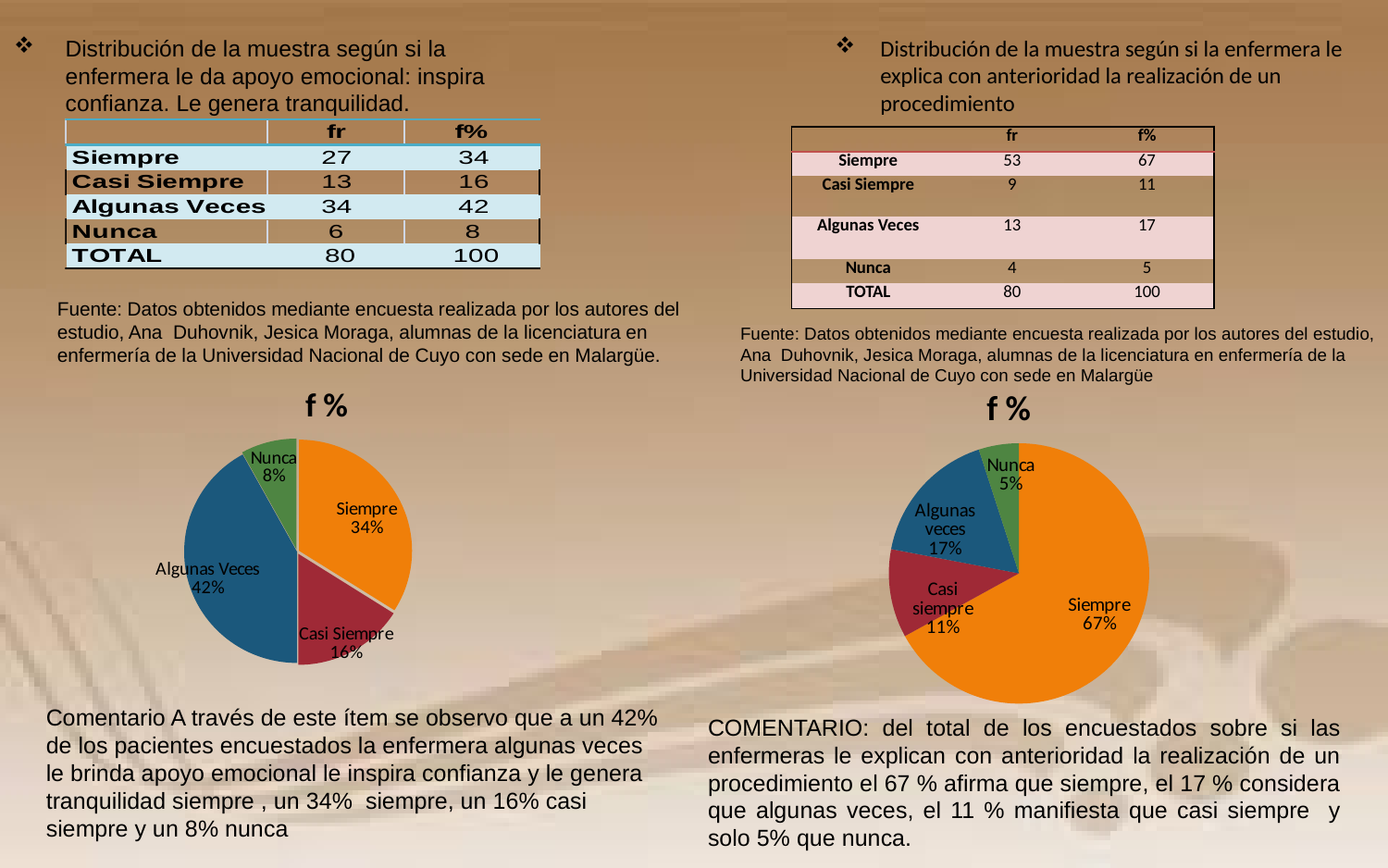
What type of chart is shown on the left side of the slide? Pie chart In the left pie chart, what is the value for Algunas Veces? 42% In the left pie chart, which is larger, Siempre or Casi Siempre? Siempre In the right pie chart, what is the value for Nunca? 5% How many slices does the right pie chart have? 4 What is the title of the right pie chart? f % In the left pie chart, what is the difference between Algunas Veces and Siempre? 8% In the left pie chart, which category has the largest slice? Algunas Veces In the right pie chart, what is the difference between Siempre and Algunas veces? 50% In the right pie chart, which category has the smallest slice? Nunca In the left pie chart, what is the value for Casi Siempre? 16% In the right pie chart, what is the value for Siempre? 67%